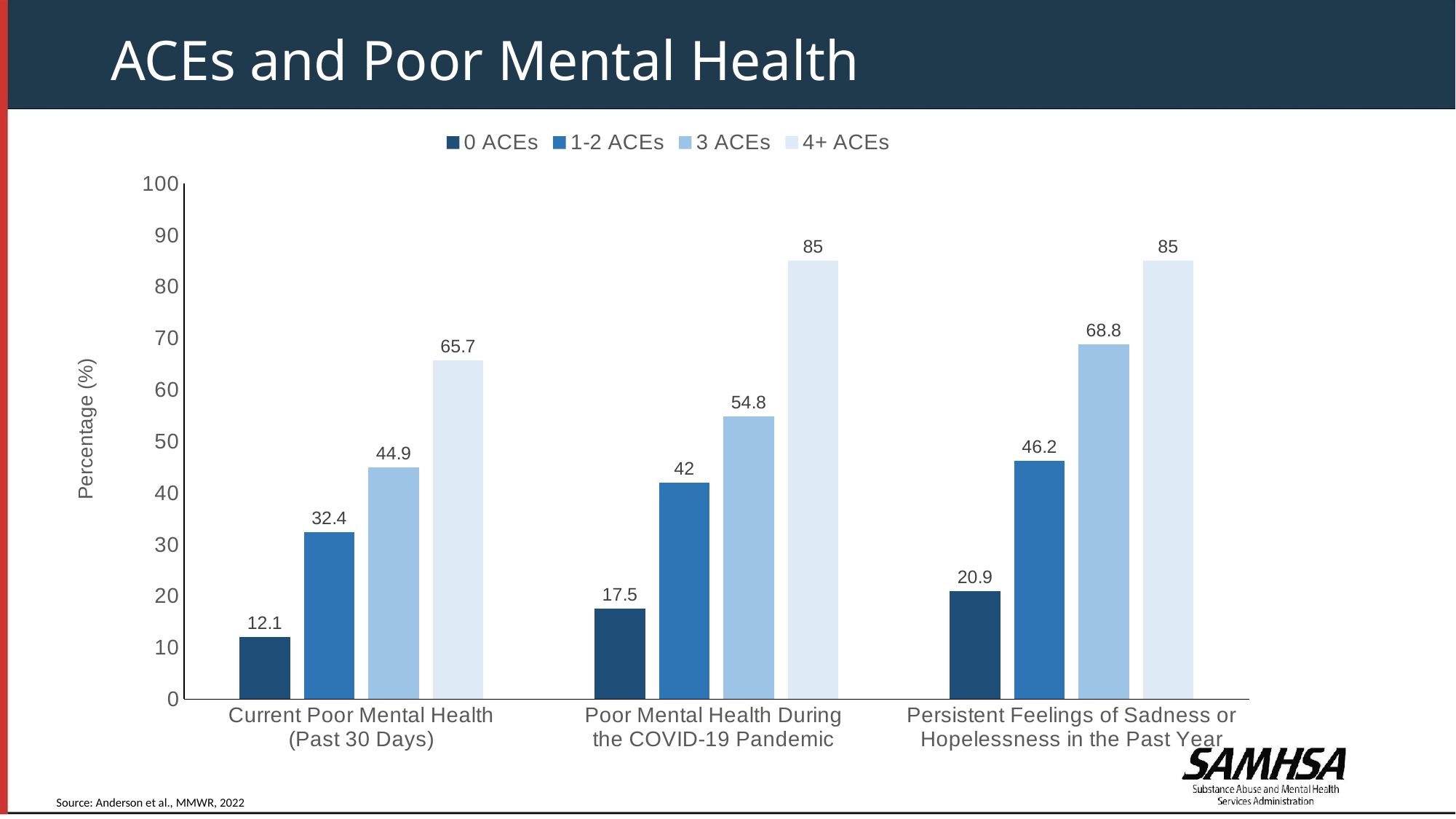
What kind of chart is shown on the slide? Bar chart Which series has the highest value in the Persistent Feelings of Sadness or Hopelessness in the Past Year category? 4+ ACEs What is the value for 4+ ACEs in the Current Poor Mental Health (Past 30 Days) category? 65.7 How many categories are shown on the x axis? 3 What is the difference between the 4+ ACEs and 0 ACEs values in the Current Poor Mental Health (Past 30 Days) category? 53.6 How many series does the legend list? 4 What is the value for 3 ACEs in the Persistent Feelings of Sadness or Hopelessness in the Past Year category? 68.8 What is the value for 0 ACEs in the Poor Mental Health During the COVID-19 Pandemic category? 17.5 What is the label of the y axis? Percentage (%) Which category has the lowest value for 0 ACEs? Current Poor Mental Health (Past 30 Days) Which is larger: the 1-2 ACEs value for Poor Mental Health During the COVID-19 Pandemic or the 1-2 ACEs value for Persistent Feelings of Sadness or Hopelessness in the Past Year? Persistent Feelings of Sadness or Hopelessness in the Past Year Is the value for 3 ACEs in the Poor Mental Health During the COVID-19 Pandemic category greater or less than 50? greater